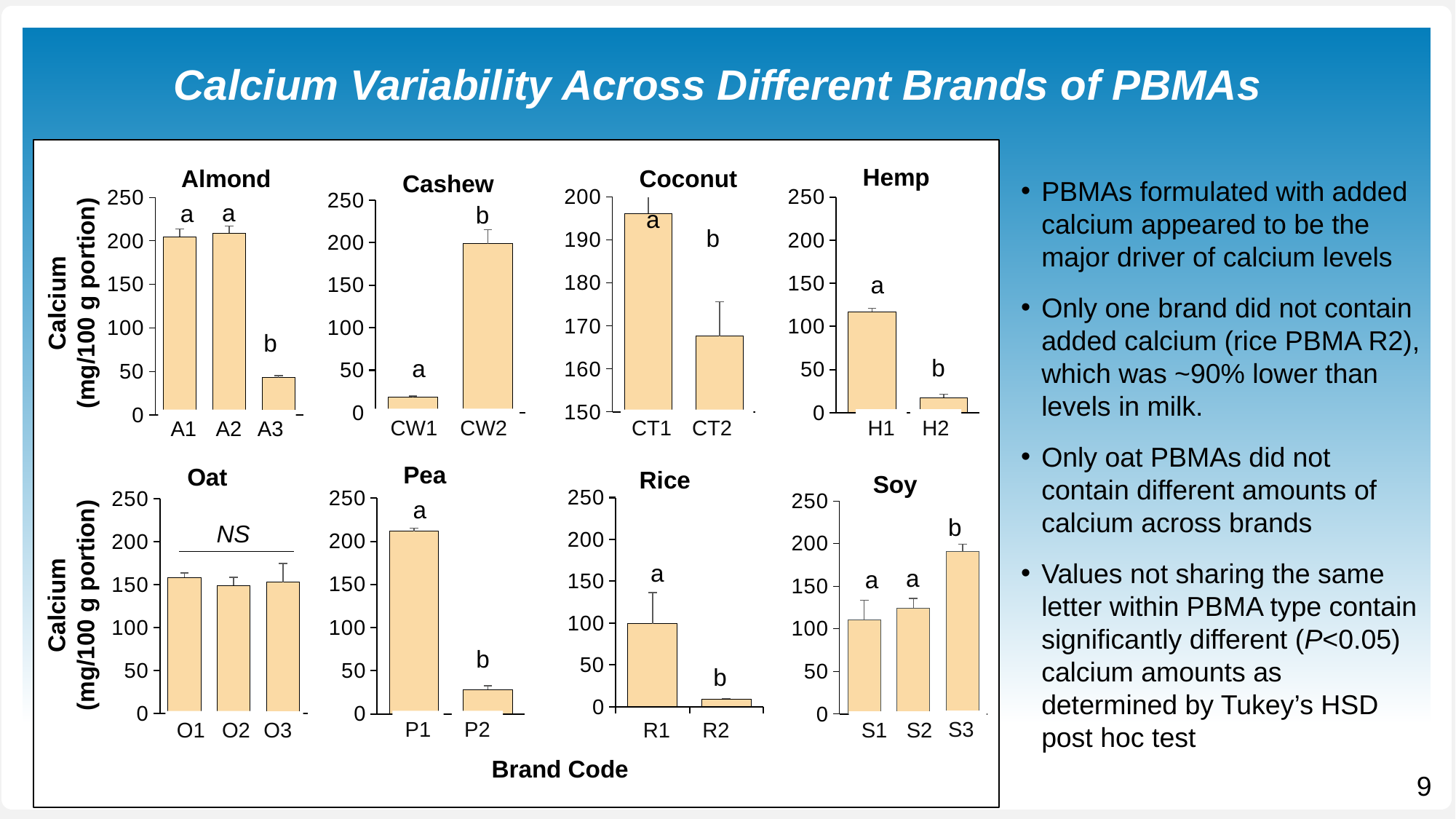
In the Hemp chart, is the value for H1 greater or less than 100? greater In the Almond chart, which brand has the lowest calcium value? A3 In the Almond chart, how many brands are plotted? 3 In the Cashew chart, is the value for CW1 greater or less than 50? less In the Pea chart, is the value for P1 greater or less than 200? greater In the Cashew chart, which brand has the higher calcium value, CW1 or CW2? CW2 In the Oat chart, how many brands are plotted? 3 What kind of chart is the Almond chart? bar chart In the Rice chart, which brand has the lowest calcium value? R2 In the Soy chart, which brand has the highest calcium value? S3 In the Coconut chart, which brand has the highest calcium value? CT1 What is the y-axis label shared by the charts on the slide? Calcium (mg/100 g portion)